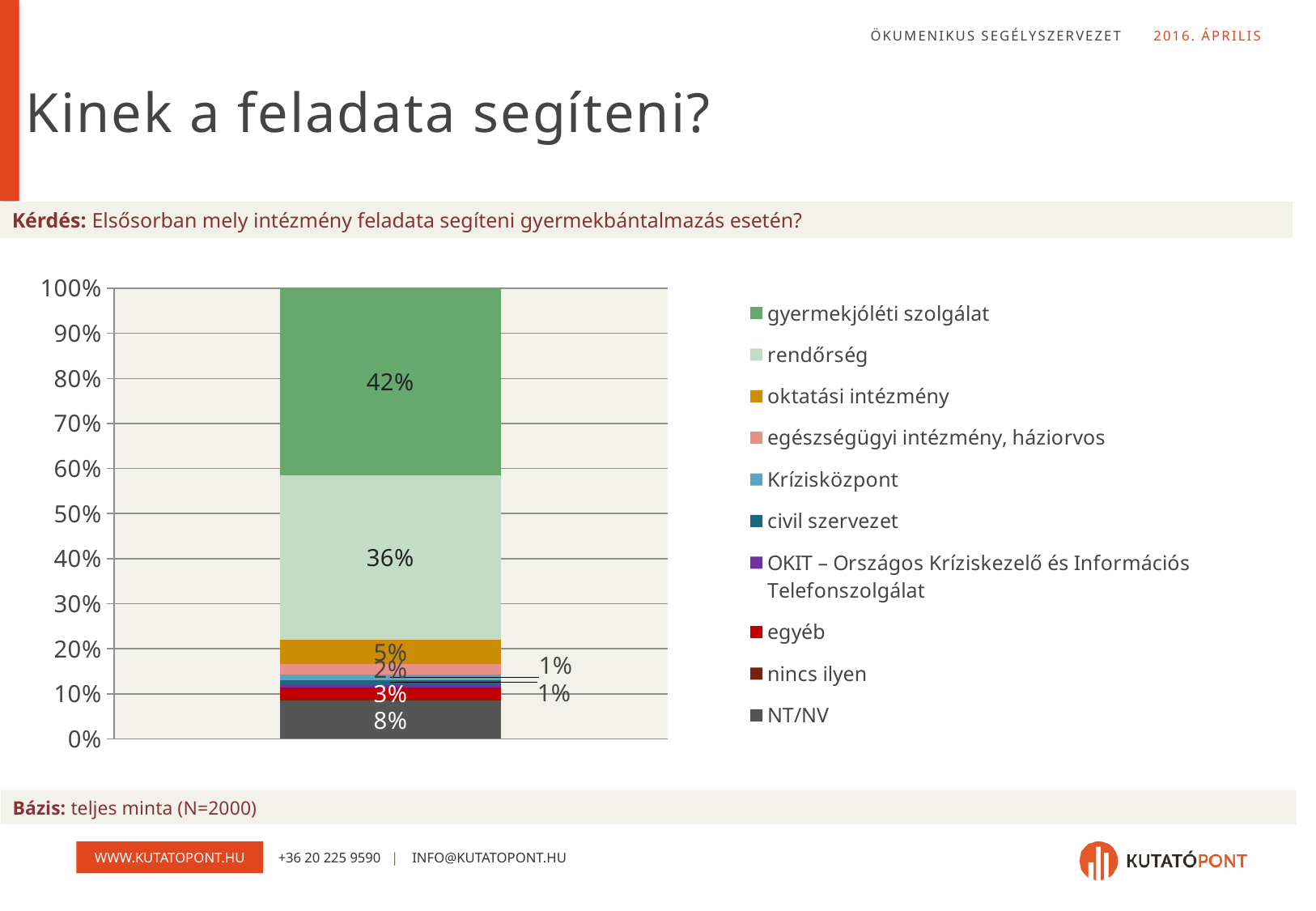
Which is larger, the share for rendőrség or the share for oktatási intézmény? rendőrség How many categories does the legend list? 10 What percentage is shown for oktatási intézmény? 5% What percentage is shown for the egyéb segment? 3% What is the value for NT/NV at the bottom of the bar? 8% How many bars are plotted in the chart? 1 What is the value shown for rendőrség in the stacked bar? 36% What percentage of respondents named gyermekjóléti szolgálat as the institution primarily responsible for helping? 42% What is the difference in percentage points between gyermekjóléti szolgálat and rendőrség? 6 percentage points What kind of chart is shown on the slide? Stacked bar chart What colour represents gyermekjóléti szolgálat in the legend? Green Which legend category has the largest share in the stacked bar? gyermekjóléti szolgálat